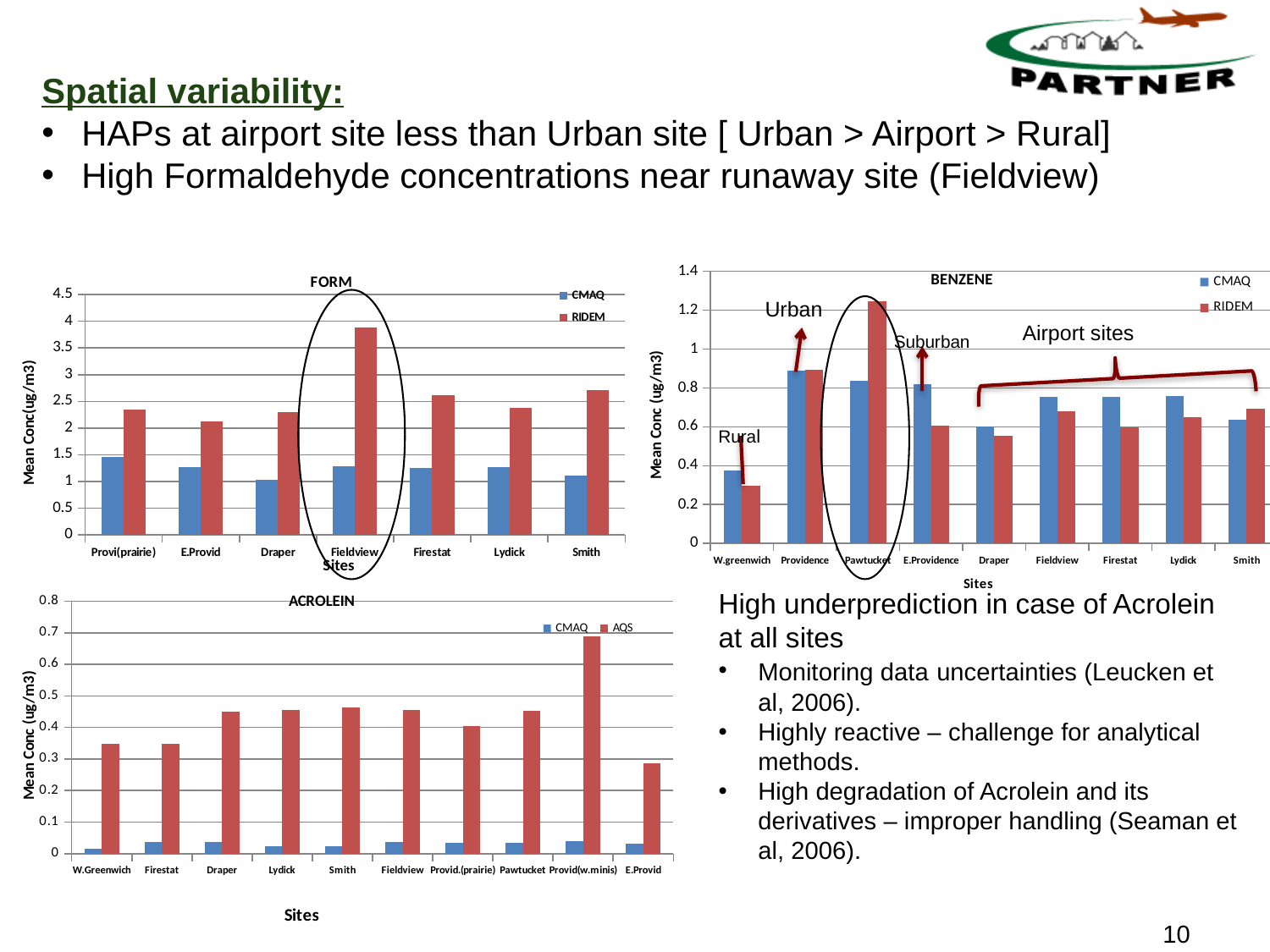
How many series does the legend of the FORM chart list? 2 How many sites are shown on the x axis of the BENZENE chart? 9 What kind of chart is the ACROLEIN chart? bar chart In the FORM chart, is the RIDEM value for E.Provid greater or less than 2.5? less How many sites are shown on the x axis of the FORM chart? 7 In the FORM chart, which site has the highest RIDEM value? Fieldview In the BENZENE chart, is the RIDEM value for Pawtucket greater or less than 1? greater In the BENZENE chart, which site has the lowest RIDEM value? W.greenwich In the BENZENE chart, which site has the highest RIDEM value? Pawtucket In the ACROLEIN chart, which site has the highest AQS value? Provid(w.minis) In the FORM chart, is the RIDEM value for Fieldview greater or less than 3.5? greater In the ACROLEIN chart, which is larger at Draper, the CMAQ value or the AQS value? AQS